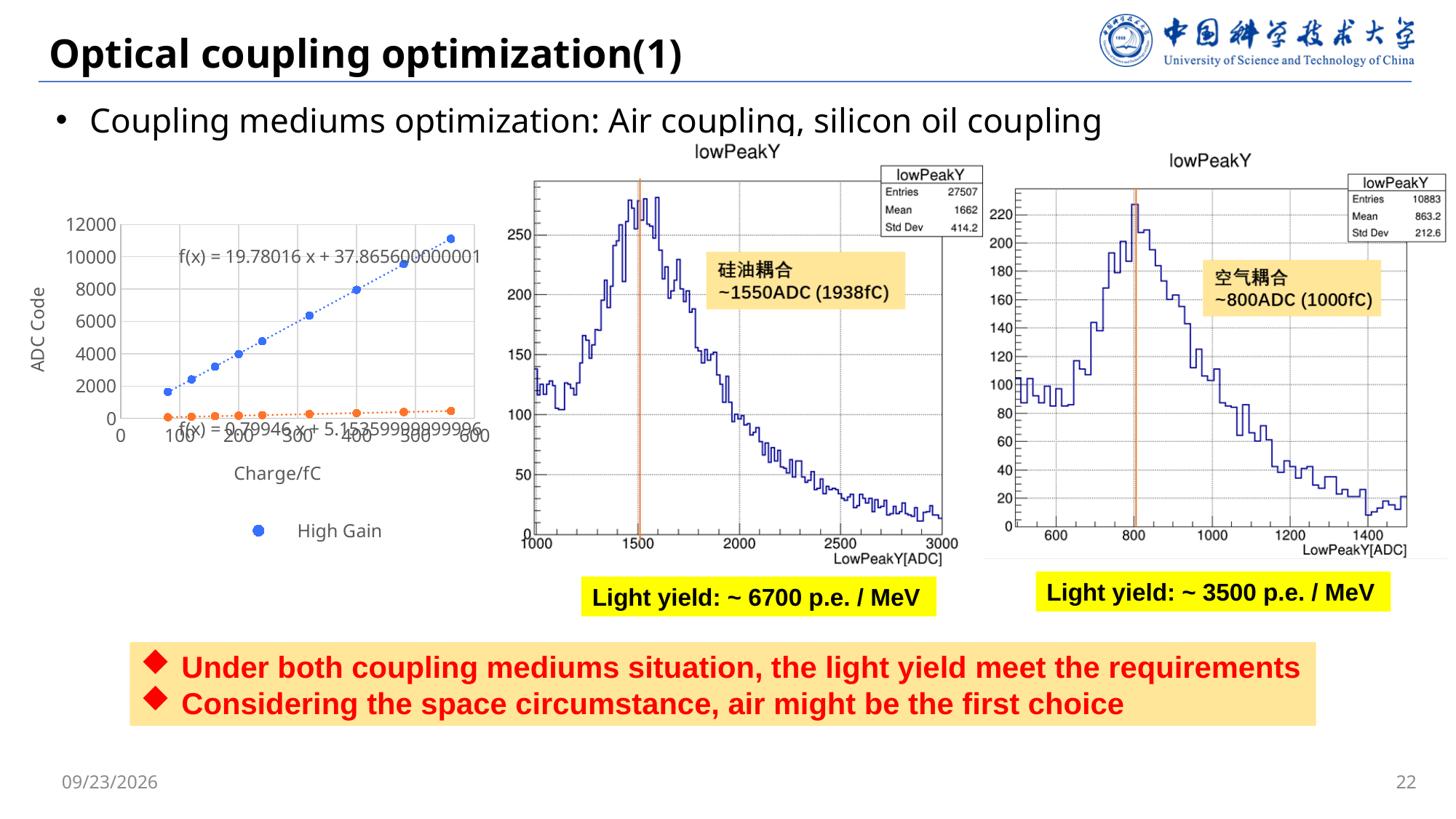
What is the difference in the number of entries between the middle lowPeakY histogram and the right-hand lowPeakY histogram? 16624 On the middle histogram titled lowPeakY, what is the Std Dev shown in the statistics box? 414.2 On the left-hand chart of ADC Code versus Charge/fC, do the High Gain values rise or fall as the charge increases? rise On the right-hand histogram titled lowPeakY, what is the Std Dev shown in the statistics box? 212.6 On the left-hand chart of ADC Code versus Charge/fC, is the High Gain value at the highest plotted charge greater or less than 10000? greater What kind of chart is the left-hand chart plotting ADC Code against Charge/fC? scatter chart On the left-hand chart of ADC Code versus Charge/fC, what is the x-axis title? Charge/fC On the middle histogram titled lowPeakY, how many entries does the statistics box report? 27507 On the middle histogram titled lowPeakY, what is the Mean shown in the statistics box? 1662 On the right-hand histogram titled lowPeakY, what is the Mean shown in the statistics box? 863.2 Which lowPeakY histogram has the larger Mean, the middle one or the right-hand one? the middle one On the right-hand histogram titled lowPeakY, how many entries does the statistics box report? 10883